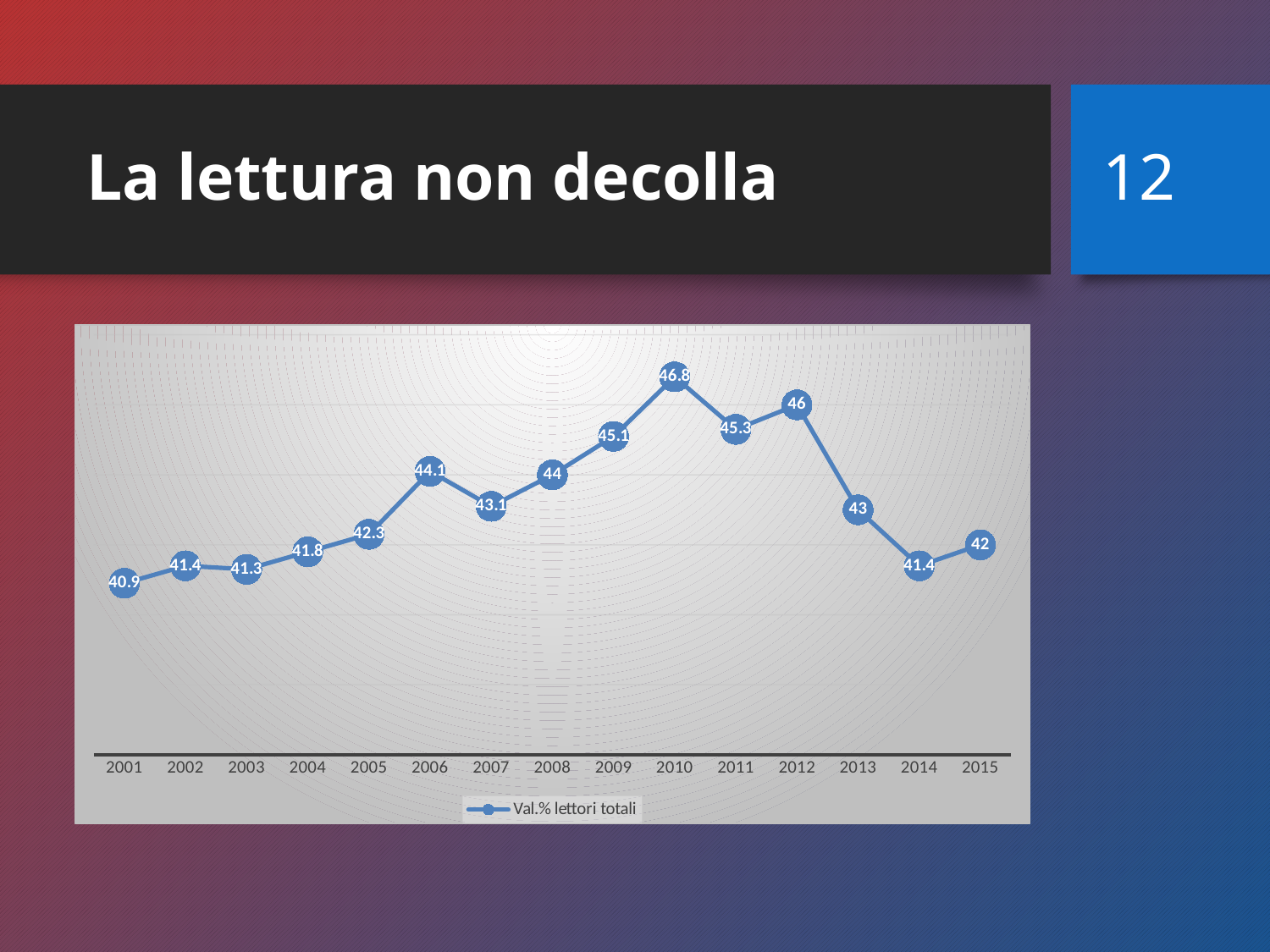
Which year has the highest value? 2010 What kind of chart is shown? line chart What is the value for 2013? 43 Which is larger, the value for 2006 or the value for 2007? 2006 What is the legend entry for the plotted series? Val.% lettori totali What is the value for 2001? 40.9 How many series does the legend list? 1 What is the value for 2010? 46.8 What is the difference between the values for 2010 and 2015? 4.8 Do the values rise or fall from 2012 to 2014? fall Which year has the lowest value? 2001 How many years are plotted on the x axis? 15